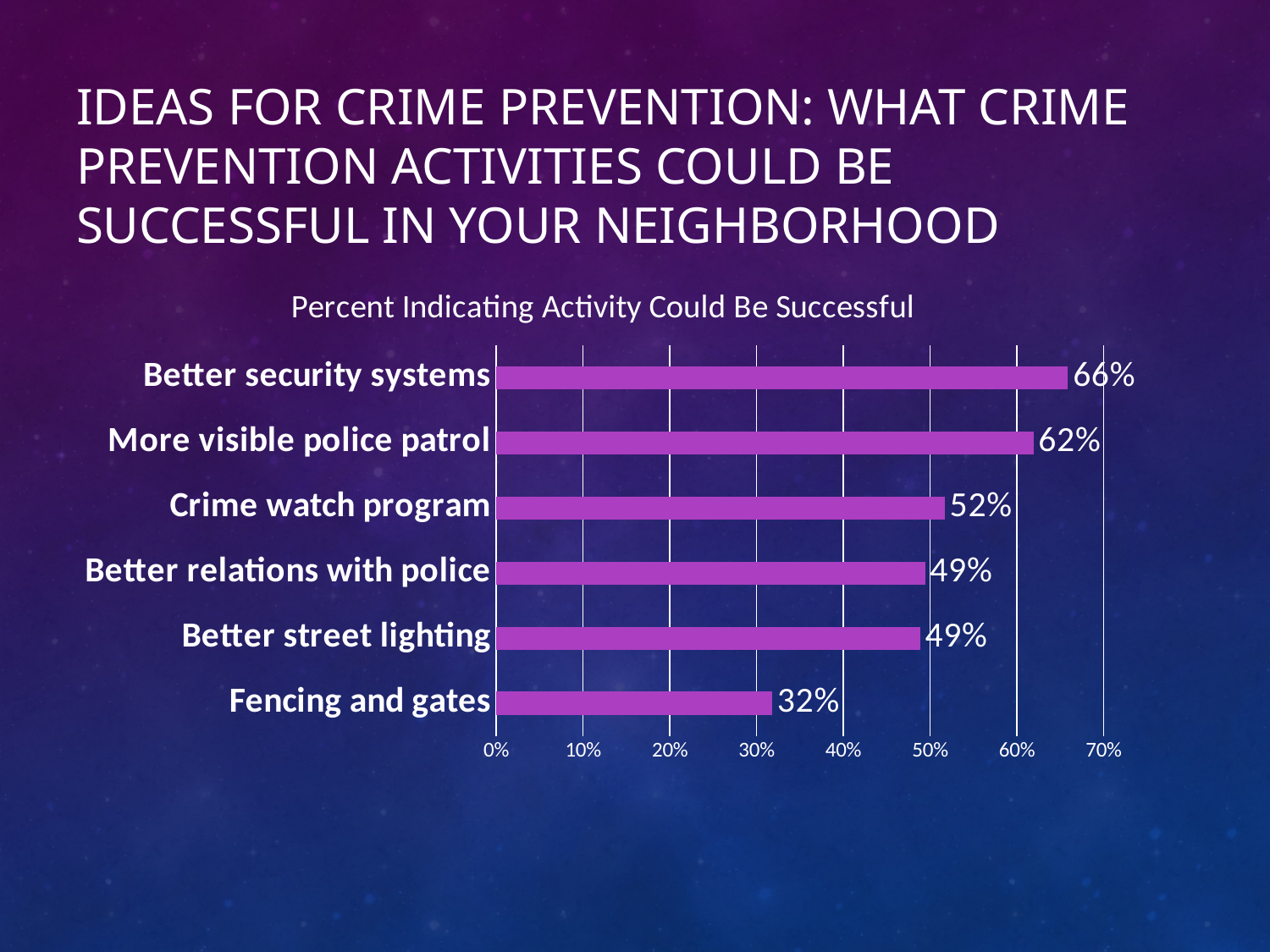
Is the value for Better street lighting greater or less than 40%? greater What is the title of the chart? Percent Indicating Activity Could Be Successful What kind of chart is shown on the slide? Bar chart How many activities are shown in the chart? 6 What is the difference between the values for Better security systems and More visible police patrol? 4% What is the value for Fencing and gates? 32% What is the difference between the values for Crime watch program and Fencing and gates? 20% Which activity has the highest percent indicating it could be successful? Better security systems What is the value for Crime watch program? 52% What percent indicated that better security systems could be successful? 66% Which activity has the lowest percent indicating it could be successful? Fencing and gates Which is larger, the value for More visible police patrol or the value for Crime watch program? More visible police patrol